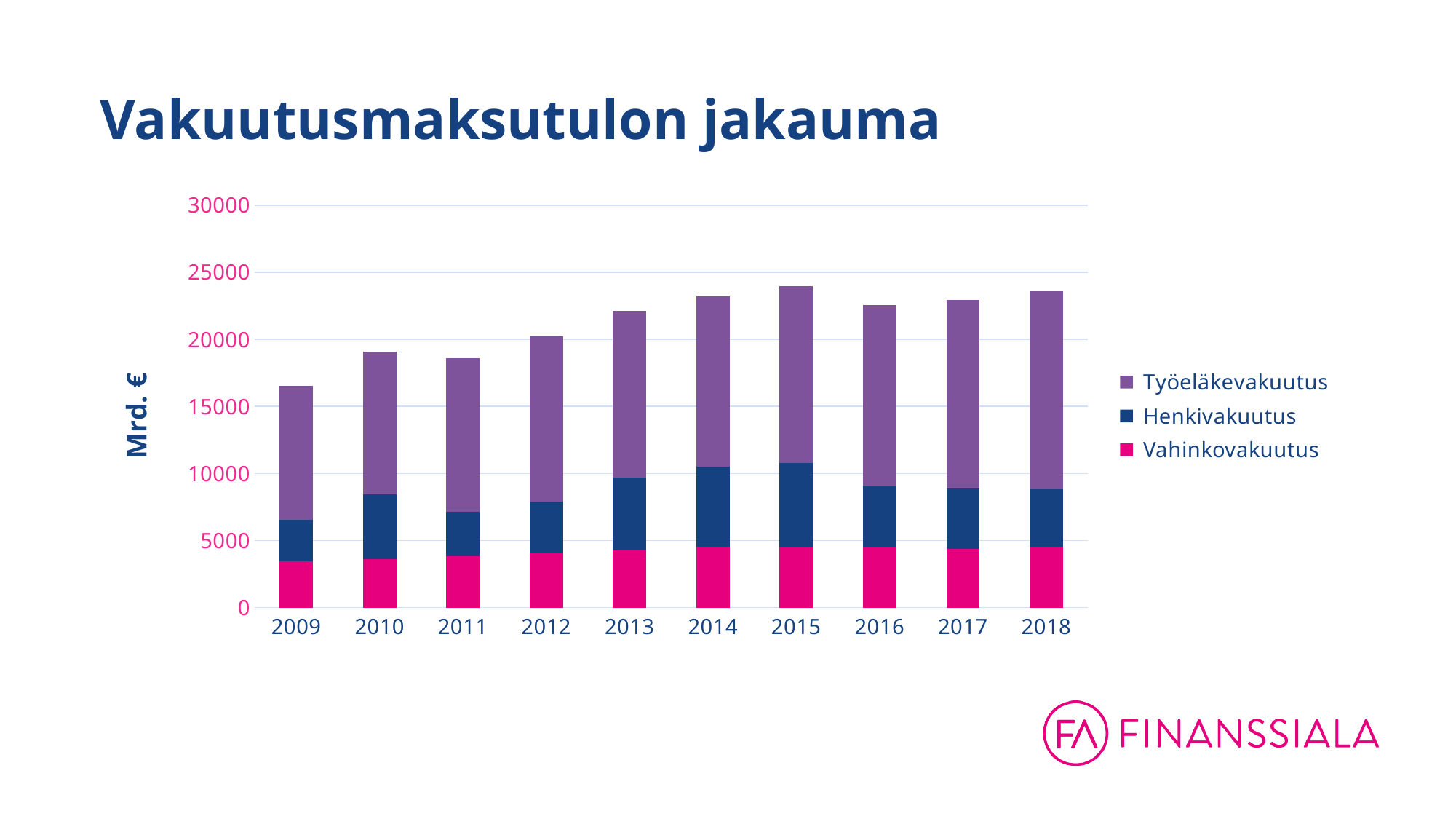
How many years are shown on the x axis? 10 How many series does the legend list? 3 Is the total bar for 2014 greater or less than 20000? greater Is the total bar for 2015 greater or less than 25000? less Do the total bars generally rise or fall from 2009 to 2015? rise Is the total bar for 2011 greater or less than 20000? less Which year has the highest total bar? 2015 Which year has the lowest total bar? 2009 What is the label on the vertical axis? Mrd. € Which year has the larger total bar, 2010 or 2011? 2010 What kind of chart is shown on the slide? Stacked bar chart